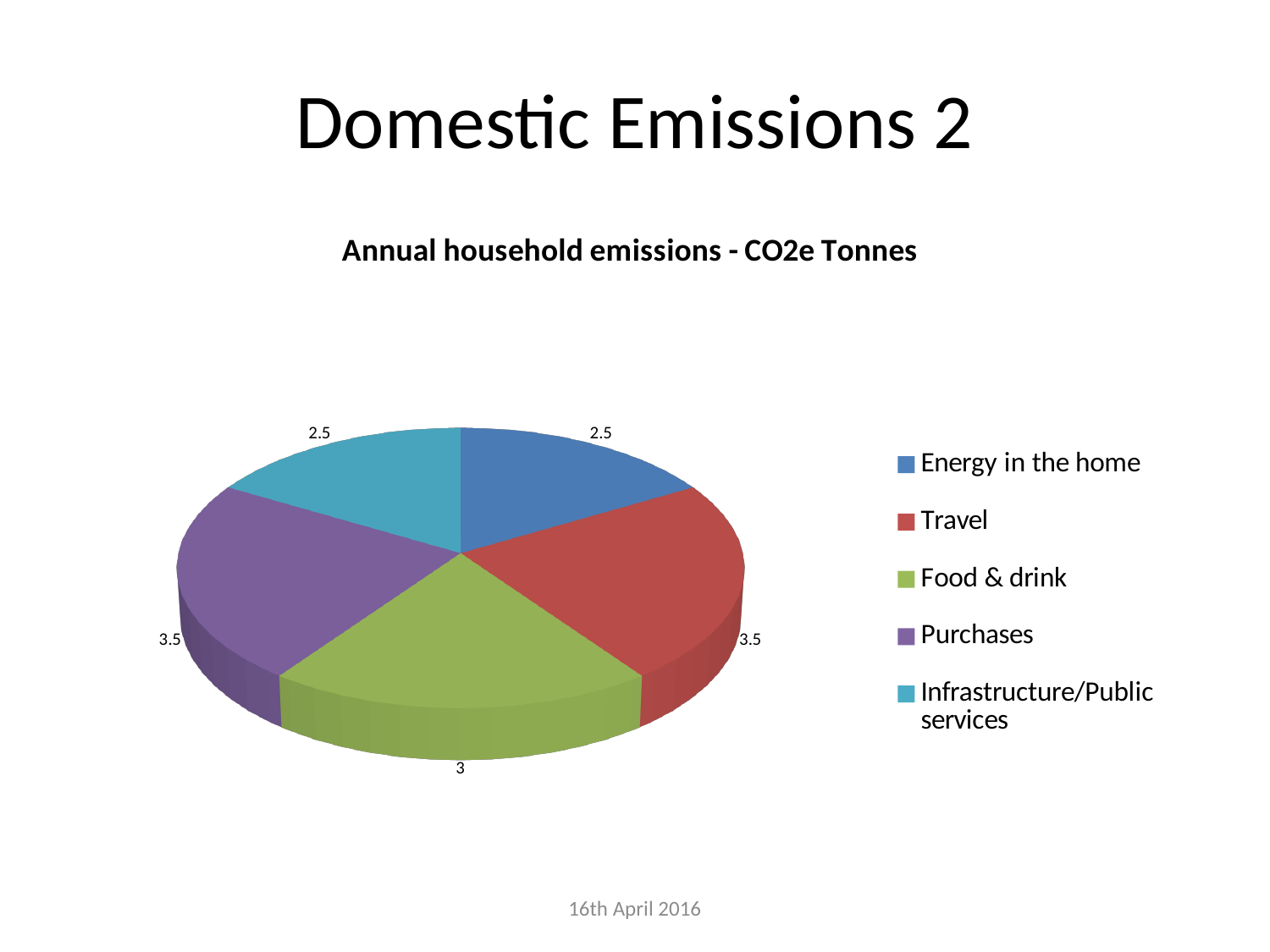
How many categories does the pie chart show? 5 Which is larger, Purchases or Food & drink? Purchases What is the value for Purchases? 3.5 What is the value for Travel in the pie chart? 3.5 What type of chart is shown on the slide? Pie chart What is the value for Energy in the home? 2.5 What is the difference between the values for Travel and Energy in the home? 1 What is the value for Infrastructure/Public services? 2.5 What is the difference between the values for Purchases and Food & drink? 0.5 Which is larger, Travel or Energy in the home? Travel What share of the total does Food & drink represent? 20% What is the value for Food & drink? 3